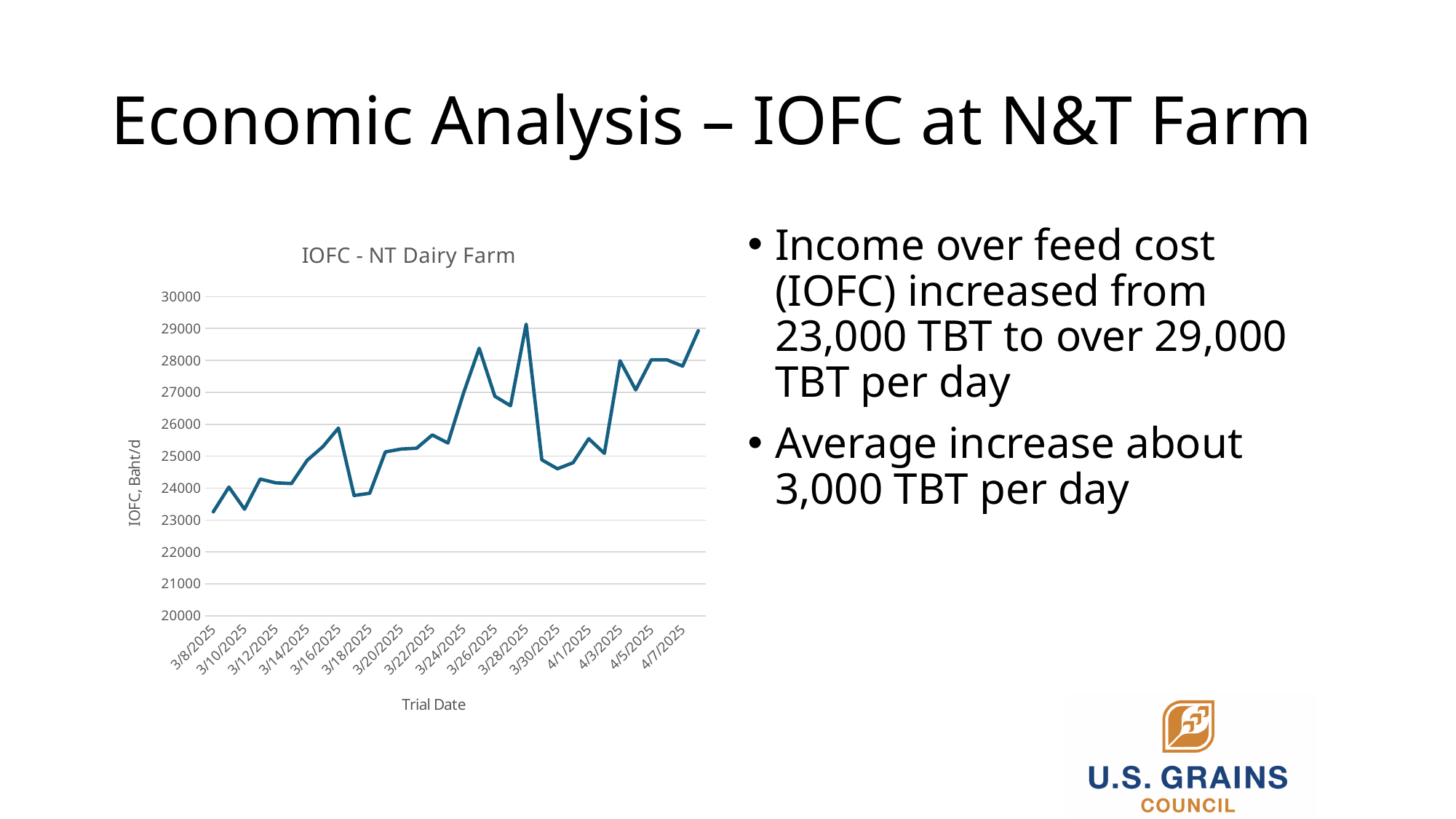
Is the value for 3/28/2025 greater or less than 28000? greater What is the label on the vertical axis of the chart? IOFC, Baht/d Is the value for 3/26/2025 greater or less than 28000? less What kind of chart is shown on the slide? line chart Is the value for 3/18/2025 greater or less than 24000? less Which has the larger value, 3/28/2025 or 3/30/2025? 3/28/2025 Which has the larger value, 3/26/2025 or 3/18/2025? 3/26/2025 Overall, do the IOFC values rise or fall from 3/8/2025 to the end of the trial? rise What is the title of the chart? IOFC - NT Dairy Farm